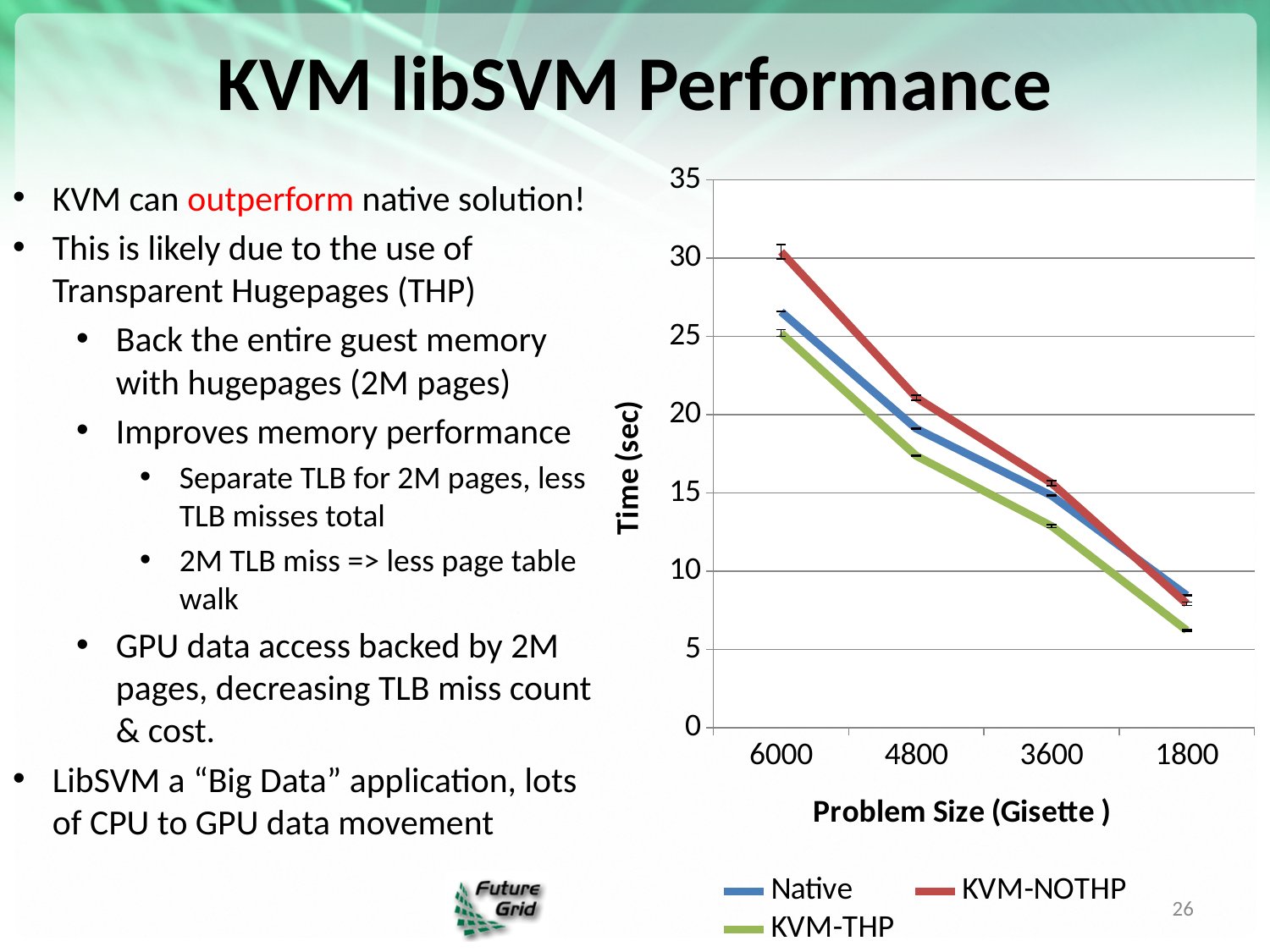
Do the times rise or fall moving from left to right along the x axis? fall Which series has the lowest time at problem size 6000? KVM-THP Is the value for KVM-THP at problem size 1800 greater or less than 10? less How many problem sizes are plotted along the x axis? 4 At problem size 4800, which is larger: the time for Native or the time for KVM-THP? Native Is the value for KVM-THP at problem size 6000 greater or less than 30? less How many series does the chart legend list? 3 Which series has the highest time at problem size 6000? KVM-NOTHP What is the title of the y axis? Time (sec) Is the value for KVM-NOTHP at problem size 4800 greater or less than 20? greater What kind of chart is shown on the slide? line chart